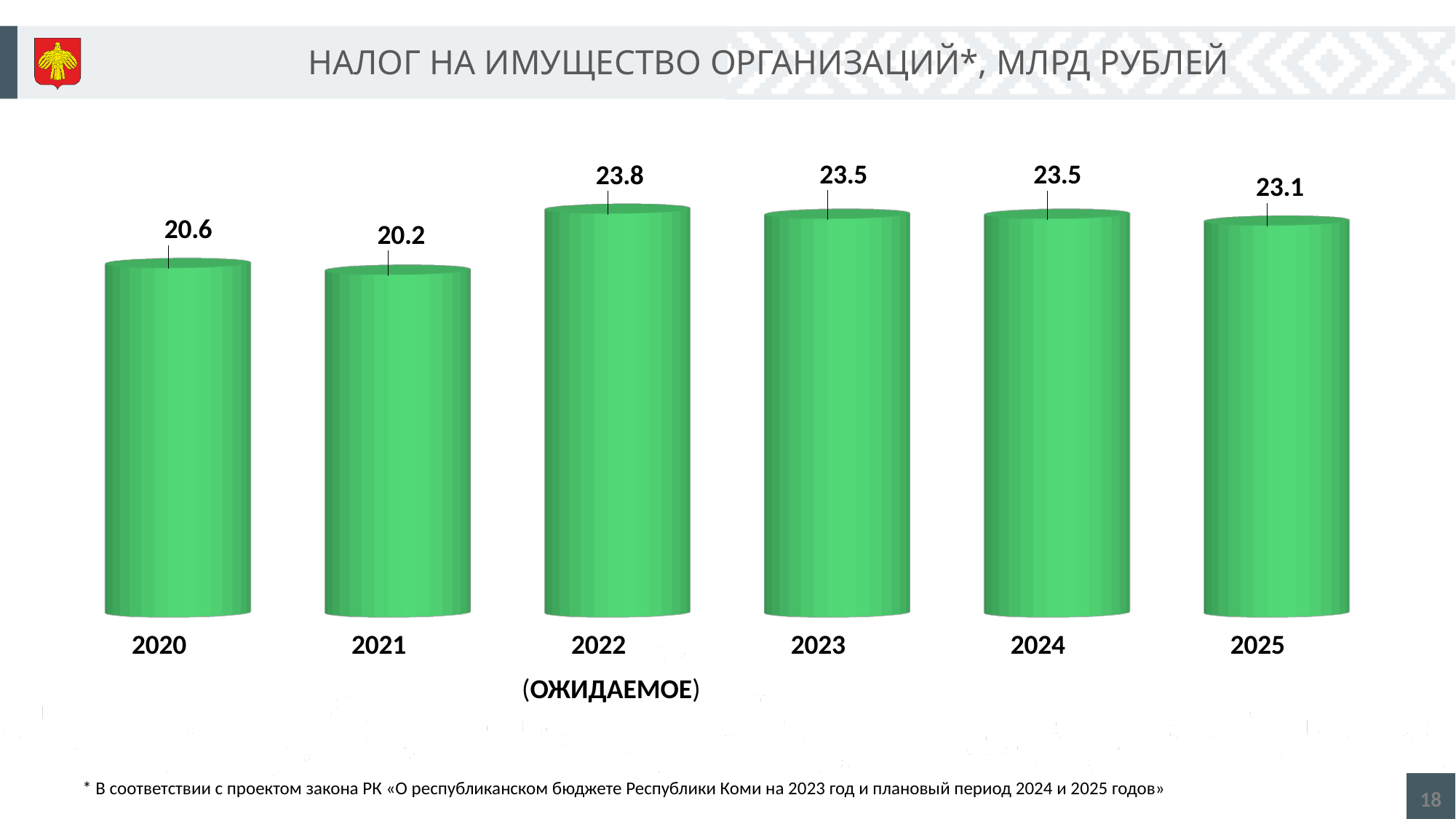
What is the difference between the values for 2020 and 2025? 2.5 Do the values rise or fall from 2022 to 2025? fall What is the value for 2025? 23.1 Which is larger, the value for 2023 or the value for 2025? 2023 What is the title of the chart? НАЛОГ НА ИМУЩЕСТВО ОРГАНИЗАЦИЙ*, МЛРД РУБЛЕЙ What is the value for 2020? 20.6 What is the value for 2022 (ОЖИДАЕМОЕ)? 23.8 What kind of chart is shown on the slide? bar chart How many years are shown on the chart? 6 What is the difference between the values for 2022 and 2021? 3.6 Which year has the lowest value? 2021 Which year has the highest value? 2022